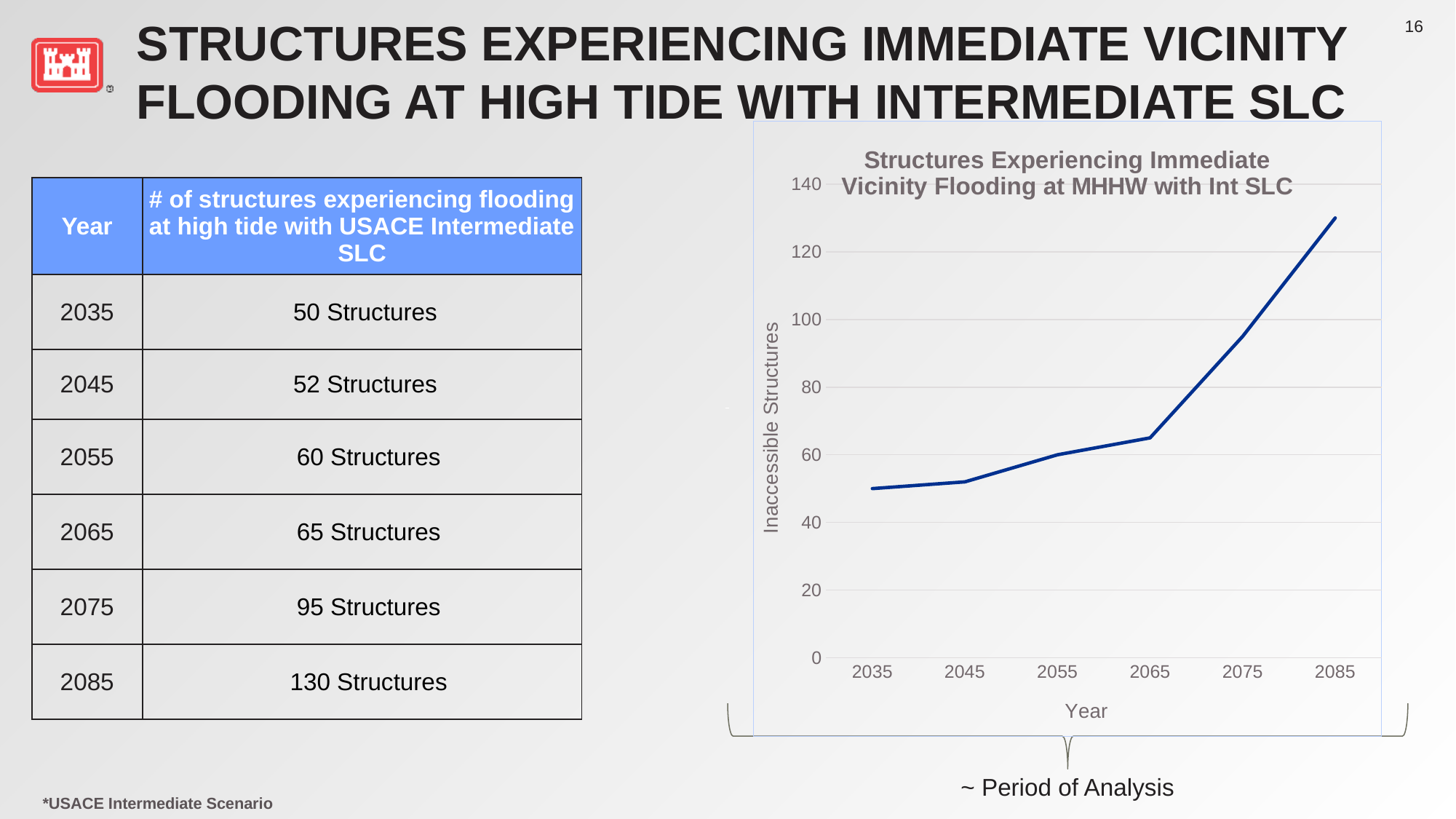
Do the values in the chart rise or fall from 2035 to 2085? rise What is the label of the y axis of the chart? Inaccessible Structures Is the value for 2065 in the chart greater or less than 80? less How many years are plotted along the x axis of the chart? 6 Which year has a larger value in the chart, 2075 or 2055? 2075 What is the title of the chart? Structures Experiencing Immediate Vicinity Flooding at MHHW with Int SLC Is the value for 2085 in the chart greater or less than 120? greater According to the slide, what is the difference between the number of structures in 2085 and in 2035? 80 What kind of chart is shown on the slide? line chart Which year has the highest number of inaccessible structures in the chart? 2085 According to the slide, how many structures experience flooding at high tide in 2075? 95 Structures Which year has the lowest number of inaccessible structures in the chart? 2035